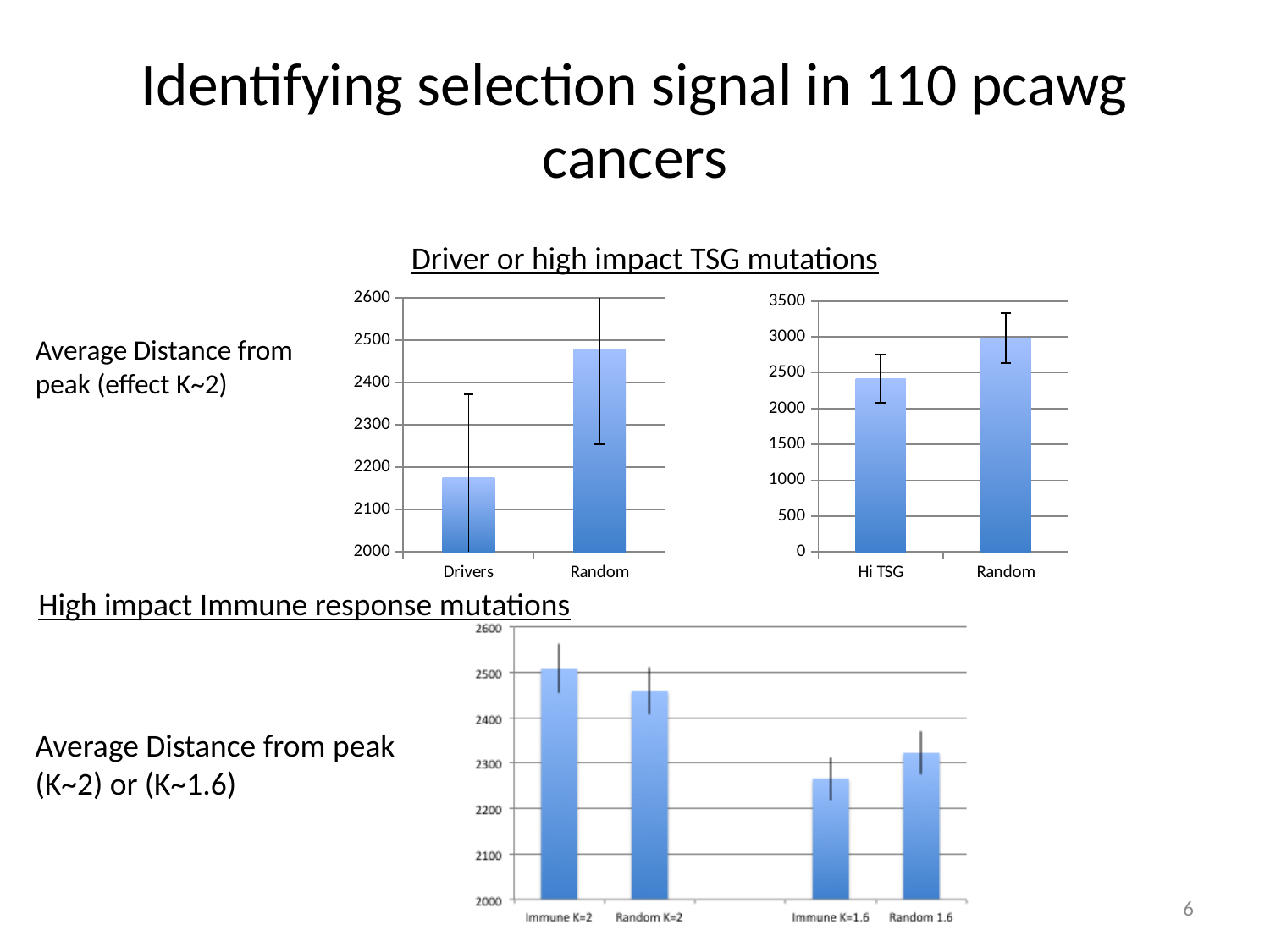
How many bars are plotted in the top-left chart (Drivers and Random)? 2 In the bottom chart, is the value for Random 1.6 greater or less than 2400? less In the top-left chart (Drivers and Random), is the value for Drivers greater or less than 2200? less What type of chart is the bottom chart (Immune K=2, Random K=2, Immune K=1.6, Random 1.6)? bar chart How many categories are shown on the x axis of the bottom chart? 4 In the top-left chart (Drivers and Random), is the value for Random greater or less than 2400? greater In the bottom chart, which category has the lowest bar? Immune K=1.6 In the bottom chart, which category has the highest bar? Immune K=2 In the top-left chart (Drivers and Random), which category has the higher bar? Random In the top-right chart (Hi TSG and Random), which category has the lowest bar? Hi TSG